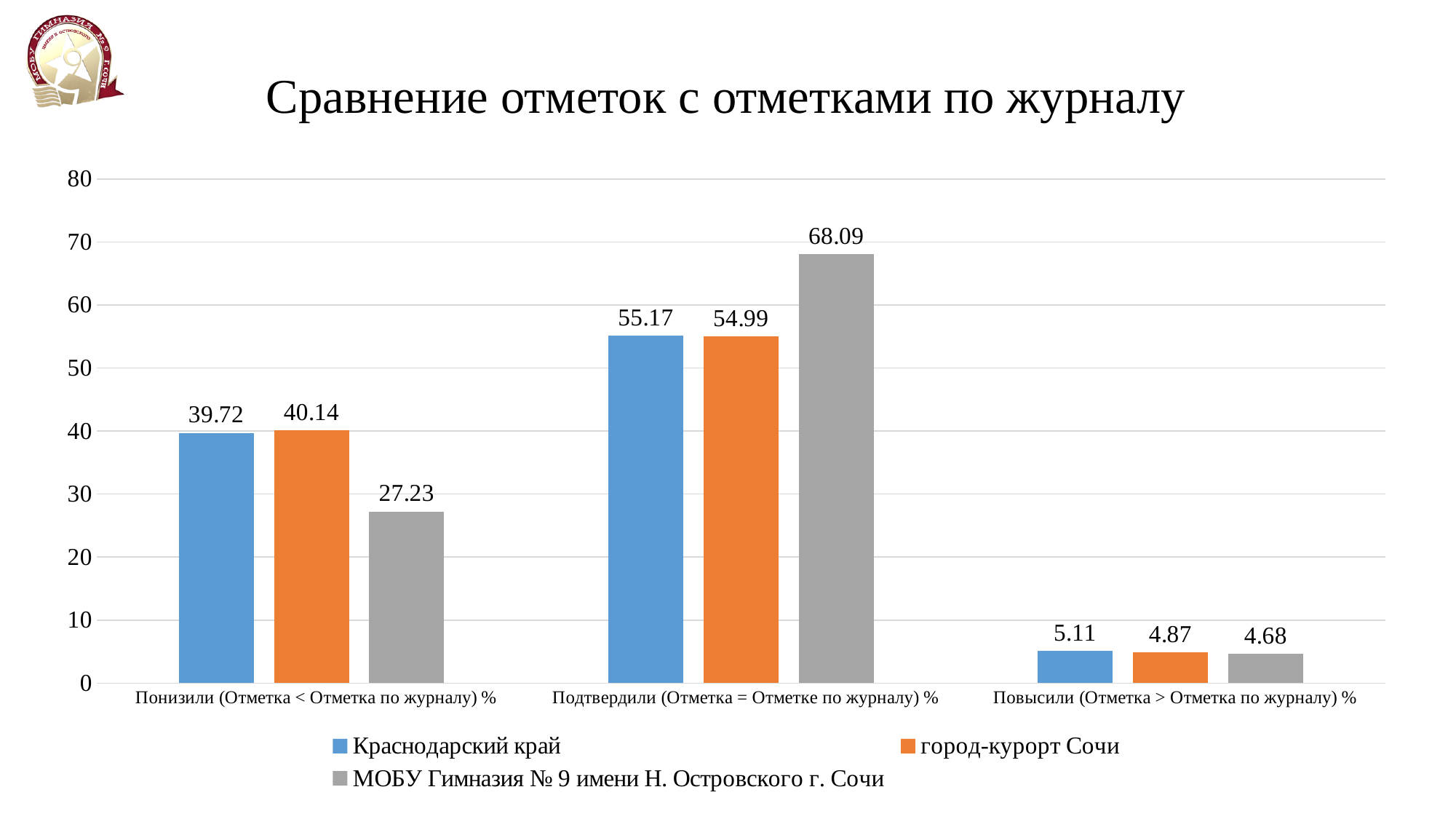
How many categories are shown on the x axis? 3 Which series has the lowest value in the category Понизили (Отметка < Отметка по журналу) %? МОБУ Гимназия № 9 имени Н. Островского г. Сочи Is the value for МОБУ Гимназия № 9 in the category Подтвердили (Отметка = Отметке по журналу) % greater or less than 60? greater How many series does the legend list? 3 What is the title of the slide? Сравнение отметок с отметками по журналу What is the value for Краснодарский край in the category Подтвердили (Отметка = Отметке по журналу) %? 55.17 What kind of chart is shown on the slide? bar chart Which series has the highest value in the category Подтвердили (Отметка = Отметке по журналу) %? МОБУ Гимназия № 9 имени Н. Островского г. Сочи What is the difference between the МОБУ Гимназия № 9 value and the Краснодарский край value in the category Подтвердили (Отметка = Отметке по журналу) %? 12.92 What is the value for город-курорт Сочи in the category Повысили (Отметка > Отметка по журналу) %? 4.87 What is the value for МОБУ Гимназия № 9 имени Н. Островского г. Сочи in the category Понизили (Отметка < Отметка по журналу) %? 27.23 Which is larger in the category Понизили (Отметка < Отметка по журналу) %: the value for Краснодарский край or for МОБУ Гимназия № 9? Краснодарский край